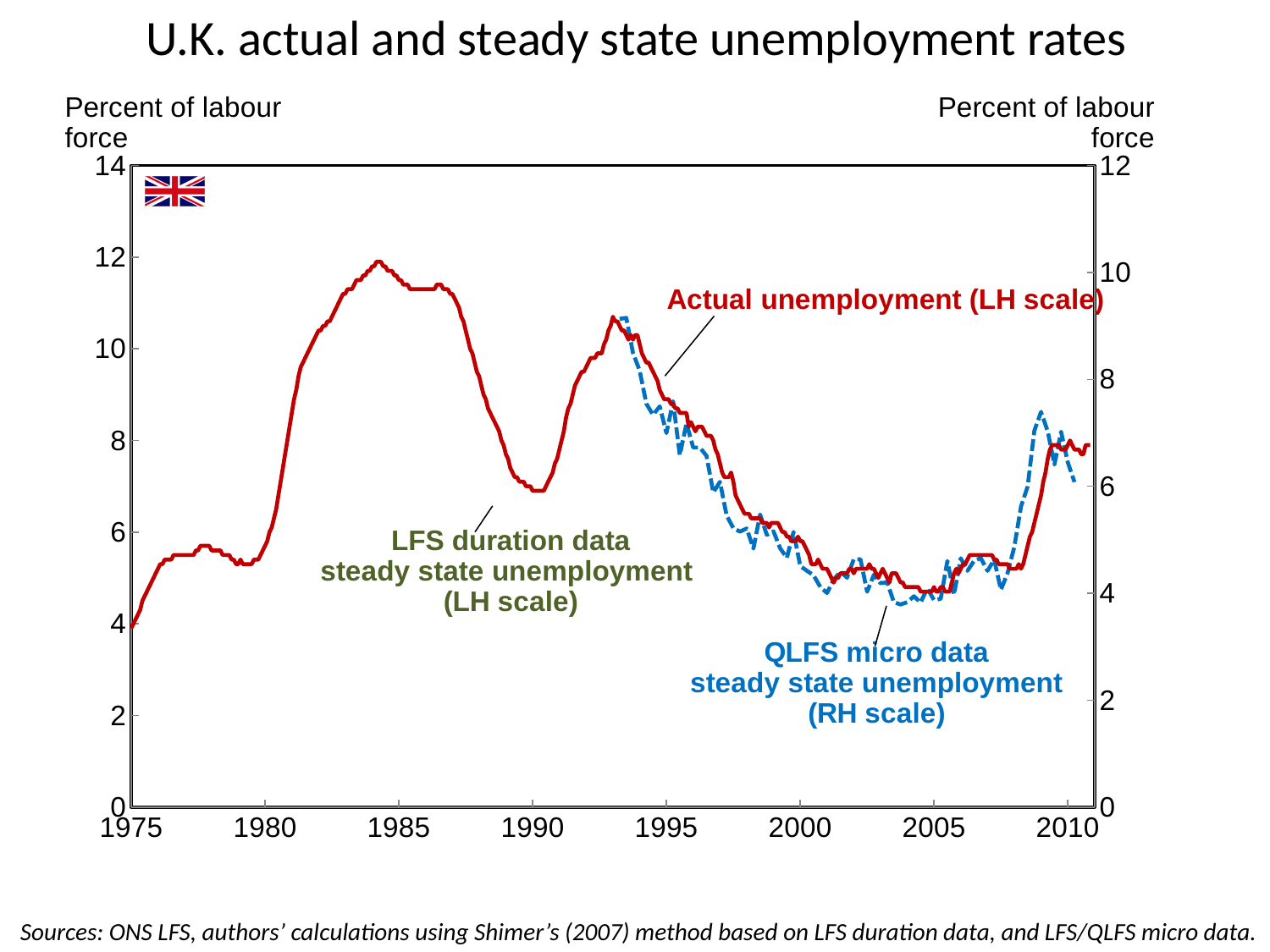
Is the actual unemployment rate around 2005 greater or less than 6 on the left-hand scale? less Which is higher for actual unemployment: the peak around 1984 or the peak around 1993? the peak around 1984 What is the highest value shown on the left-hand vertical axis? 14 Is the actual unemployment rate around 1984 greater or less than 10 on the left-hand scale? greater Does the actual unemployment rate rise or fall between 1980 and 1984? rise What kind of chart is shown on the slide? line chart How many series are labelled on the chart? 3 Does the actual unemployment rate rise or fall between 1993 and 2000? fall Is the actual unemployment rate around 2010 greater or less than 6 on the left-hand scale? greater Which series is plotted against the right-hand (RH) scale? QLFS micro data steady state unemployment What is the title of the chart? U.K. actual and steady state unemployment rates